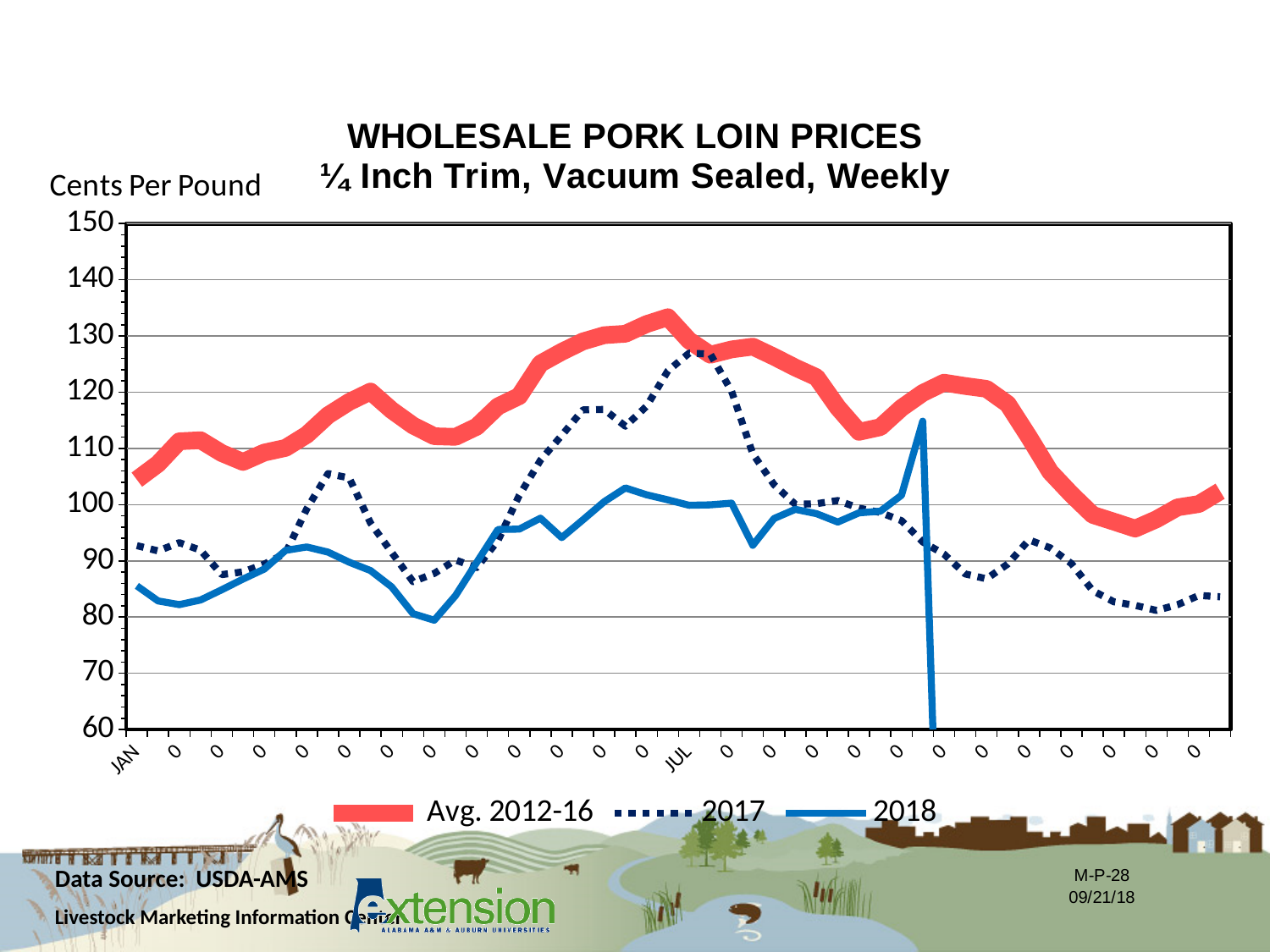
How many series does the legend list? 3 Is the value of the Avg. 2012-16 series at JAN greater or less than 100? greater Is the value of the 2018 series at JAN greater or less than 90? less What are the three series listed in the legend? Avg. 2012-16, 2017, 2018 At JAN, which series has the higher value: Avg. 2012-16 or 2018? Avg. 2012-16 What kind of chart is shown on the slide? line chart Is the peak value of the Avg. 2012-16 series greater or less than 130? greater What unit is shown on the y axis of the chart? Cents Per Pound Does the Avg. 2012-16 series rise or fall from JUL to the end of the year? fall